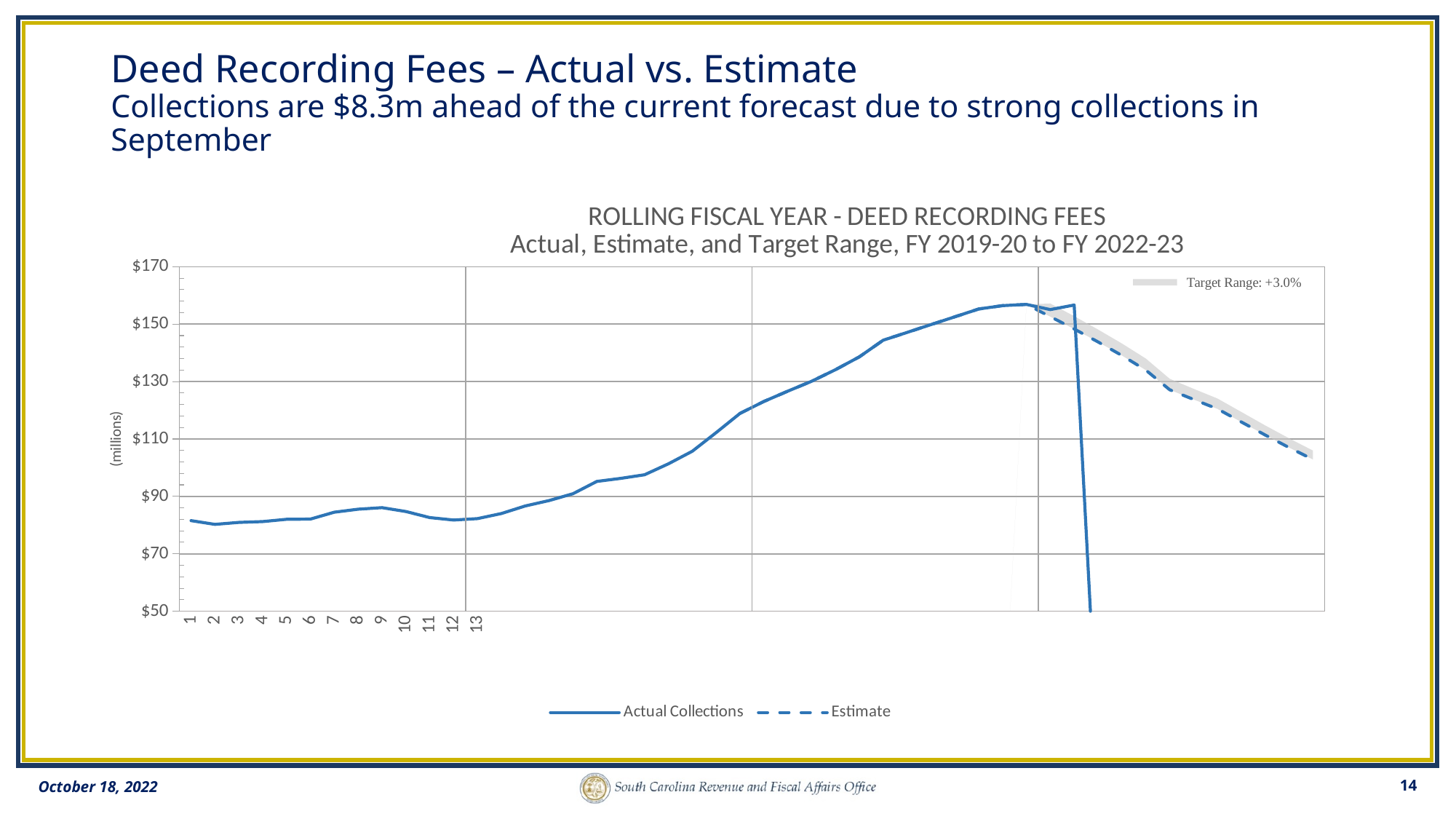
Does the Actual Collections line generally rise or fall from point 13 up to its peak? rise Is the Actual Collections value at point 1 greater or less than $90? less Does the Estimate line rise or fall from left to right? fall What are the two series named in the legend at the bottom of the chart? Actual Collections and Estimate Which is larger: the Actual Collections value at point 1 or the peak value of the Actual Collections line? The peak value Which series is drawn with a dashed line? Estimate Is the Actual Collections value at point 13 greater or less than $90? less What is the title of the chart? ROLLING FISCAL YEAR - DEED RECORDING FEES Actual, Estimate, and Target Range, FY 2019-20 to FY 2022-23 Is the final value of the Estimate line (at the right end of the chart) greater or less than $110? less How many series does the legend at the bottom of the chart list? 2 What kind of chart is shown on the slide? Line chart